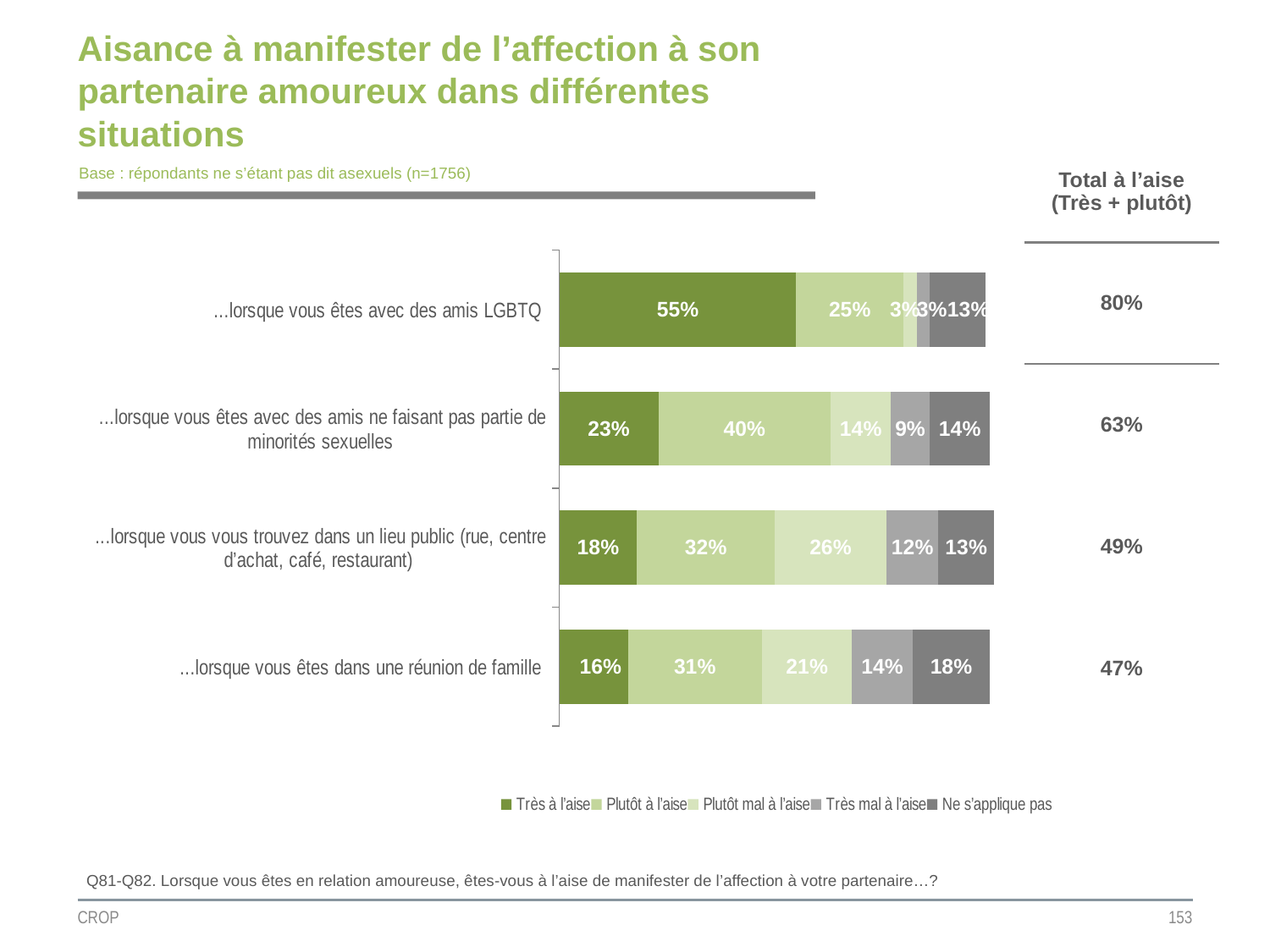
How many situations (categories) are plotted in the chart? 4 What is the 'Ne s'applique pas' value for '…lorsque vous êtes dans une réunion de famille'? 18% What is the 'Plutôt à l'aise' value for '…lorsque vous êtes avec des amis ne faisant pas partie de minorités sexuelles'? 40% How many series does the legend list? 5 What kind of chart is shown on the slide? Stacked bar chart Which situation has the lowest 'Total à l'aise (Très + plutôt)' value? …lorsque vous êtes dans une réunion de famille What is the difference between the 'Très à l'aise' values for '…lorsque vous êtes avec des amis LGBTQ' and '…lorsque vous êtes dans une réunion de famille'? 39% What is the 'Très à l'aise' value for '…lorsque vous êtes avec des amis LGBTQ'? 55% Which is larger: the 'Très mal à l'aise' value for '…lorsque vous êtes dans une réunion de famille' or for '…lorsque vous vous trouvez dans un lieu public (rue, centre d'achat, café, restaurant)'? …lorsque vous êtes dans une réunion de famille What is the 'Plutôt mal à l'aise' value for '…lorsque vous vous trouvez dans un lieu public (rue, centre d'achat, café, restaurant)'? 26% What is the 'Total à l'aise (Très + plutôt)' value for '…lorsque vous vous trouvez dans un lieu public (rue, centre d'achat, café, restaurant)'? 49% Which situation has the highest 'Très à l'aise' value? …lorsque vous êtes avec des amis LGBTQ